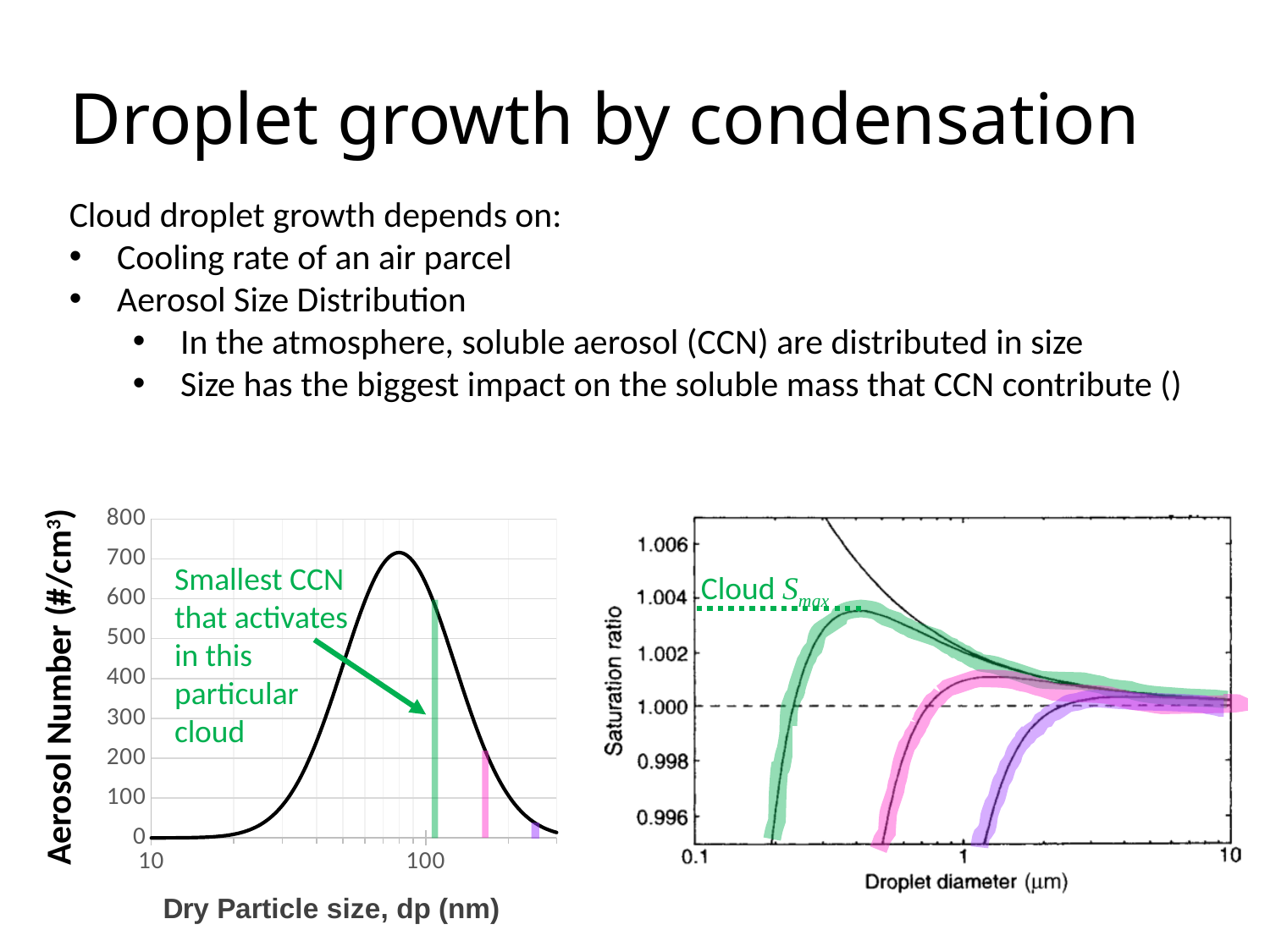
On the left chart, is the height of the pink vertical bar greater or less than 300? less On the left chart, how many coloured vertical bars are marked on the curve? 3 On the right chart, is the peak of the green curve greater or less than 1.002? greater On the left chart, is the height of the purple vertical bar greater or less than 100? less On the left chart, does the black curve rise or fall as dry particle size increases from 100 nm to 300 nm? fall On the right chart, what is the label of the x-axis? Droplet diameter (μm) On the right chart, which coloured curve has the lowest peak saturation ratio? purple What kind of chart is the left chart, titled with the x-axis 'Dry Particle size, dp (nm)'? line chart On the right chart, which coloured curve reaches the highest peak saturation ratio? green On the left chart, what is the label of the y-axis? Aerosol Number (#/cm³)